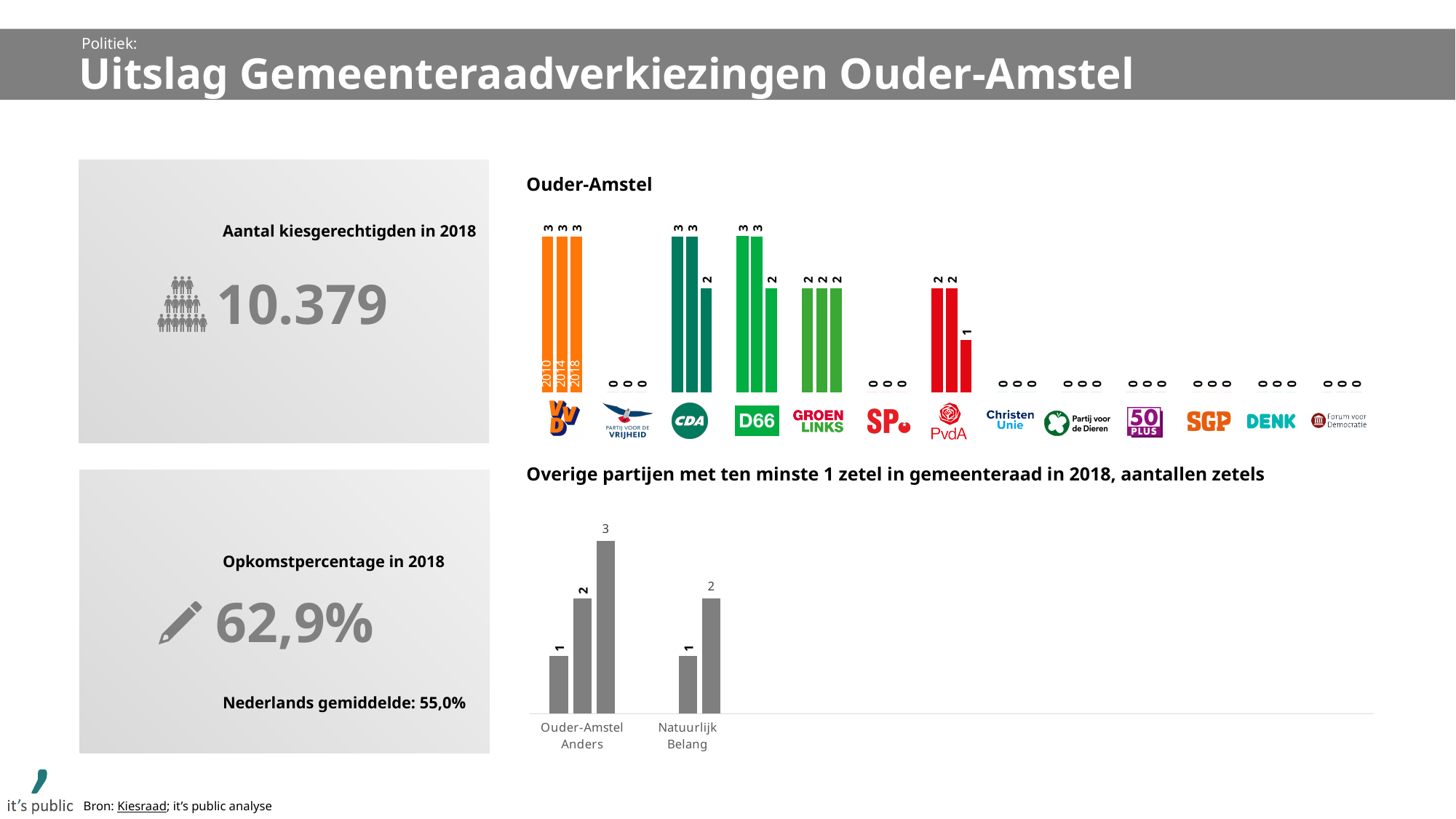
In the 'Overige partijen met ten minste 1 zetel in gemeenteraad in 2018' chart, how many parties are shown? 2 In the 'Ouder-Amstel' chart, how many seats did the PvdA have in 2018? 1 In the 'Ouder-Amstel' chart, how many seats did D66 have in 2010? 3 In the 'Overige partijen met ten minste 1 zetel in gemeenteraad in 2018' chart, what is the highest number of seats shown for Ouder-Amstel Anders? 3 In the 'Ouder-Amstel' chart, which party had more seats in 2018, GroenLinks or PvdA? GroenLinks In the 'Overige partijen met ten minste 1 zetel in gemeenteraad in 2018' chart, what is the highest number of seats shown for Natuurlijk Belang? 2 In the 'Ouder-Amstel' chart, what is the difference between the CDA's seats in 2014 and in 2018? 1 In the 'Ouder-Amstel' chart, did the number of seats for the PvdA rise or fall from 2010 to 2018? fall In the 'Ouder-Amstel' chart, how many years does each party's group of bars cover? 3 What kind of chart is the 'Overige partijen met ten minste 1 zetel in gemeenteraad in 2018' chart? bar chart In the 'Ouder-Amstel' chart, how many seats did the CDA have in 2018? 2 In the 'Ouder-Amstel' chart, how many seats did the VVD have in 2018? 3